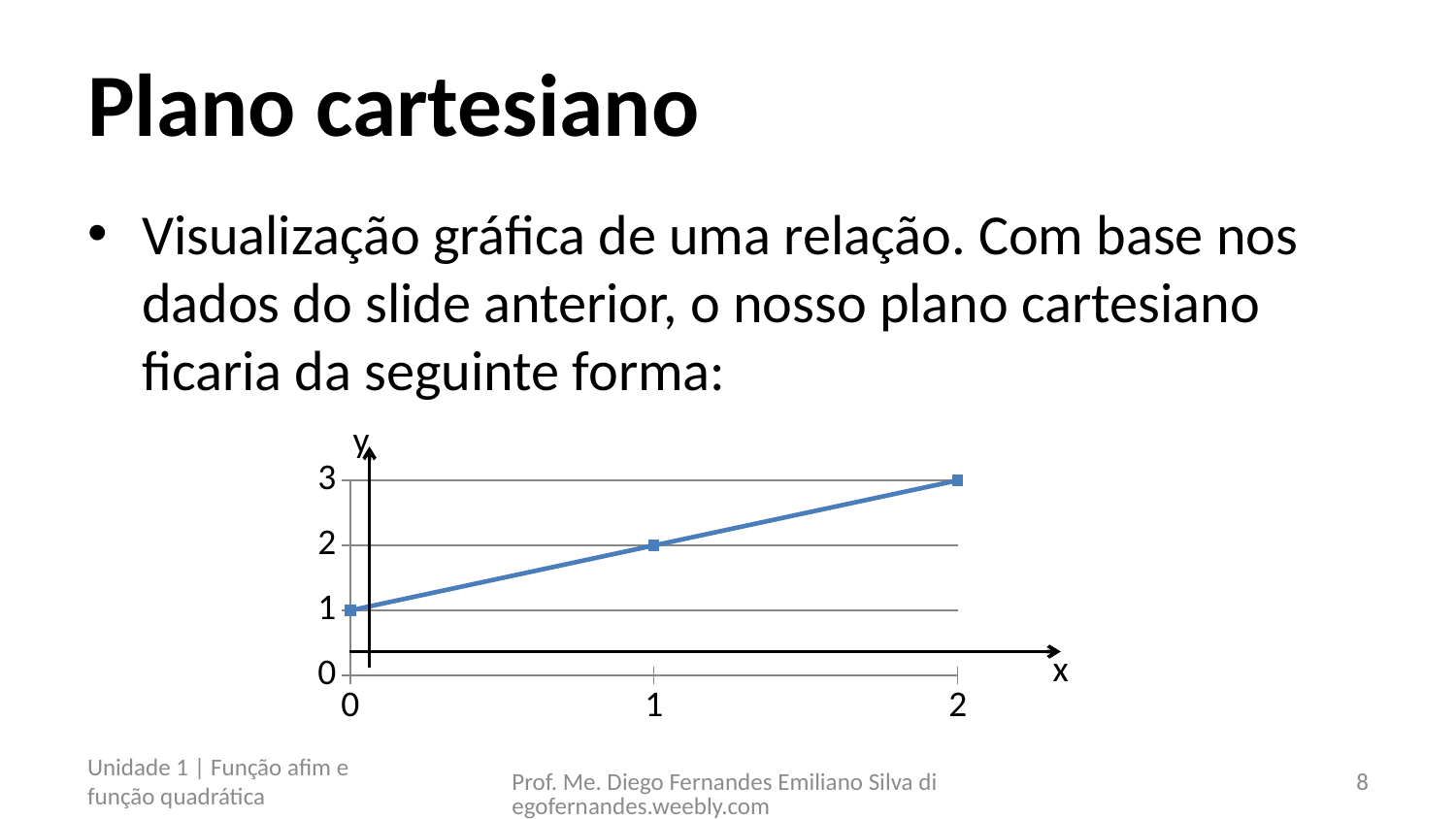
What is the y value when x is 2? 3 What is the y value when x is 1? 2 At which x value is y lowest? 0 How many data points are plotted on the line? 3 What label is shown on the horizontal axis? x Which is larger, the y value at x = 1 or the y value at x = 2? x = 2 What is the difference between the y value at x = 2 and the y value at x = 0? 2 Do the y values rise or fall as x increases? rise What label is shown on the vertical axis? y At which x value is y highest? 2 What is the y value when x is 0? 1 What kind of chart is shown on the slide? line chart